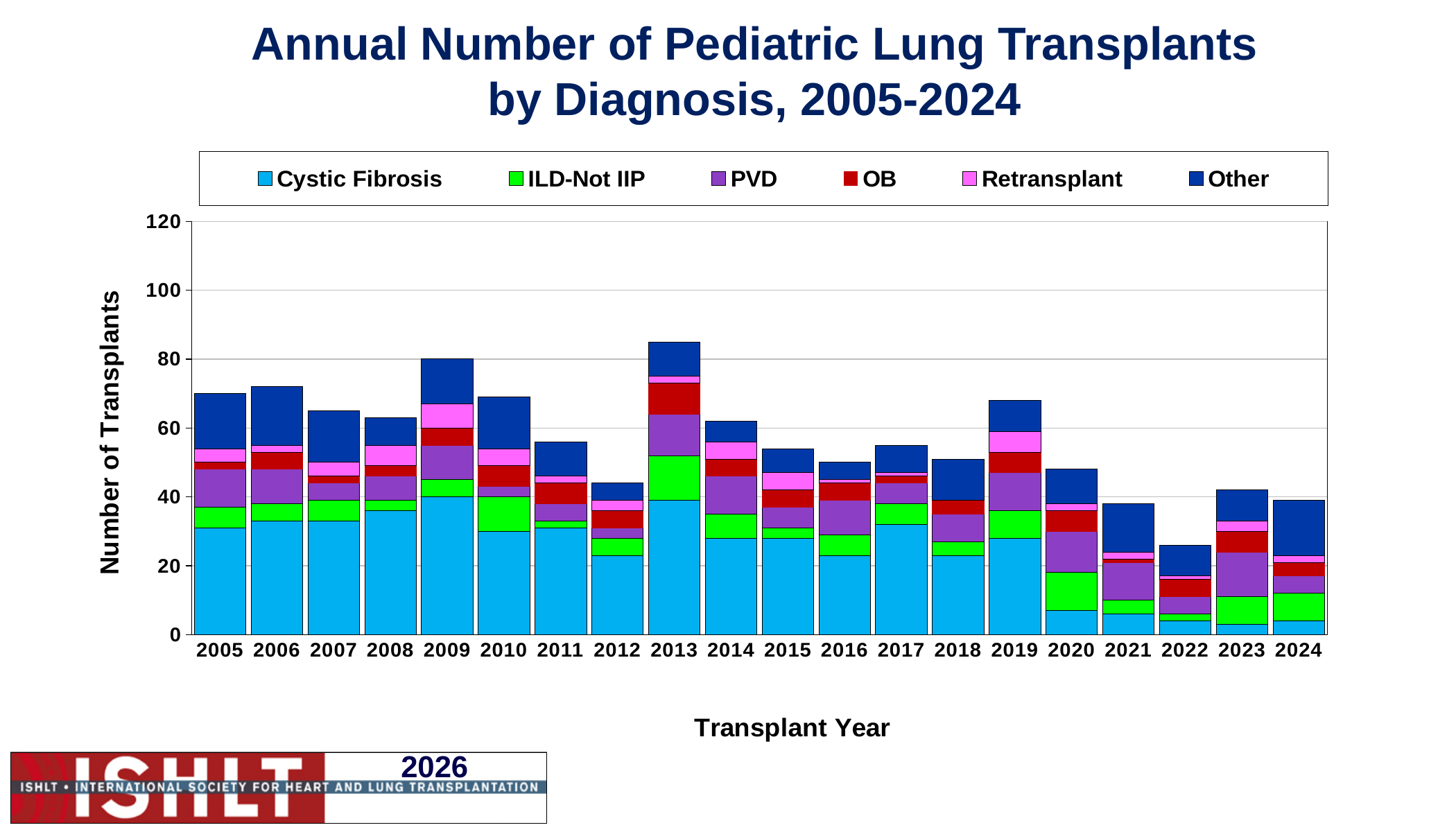
How many transplant years are shown along the x axis? 20 Which year has a larger total number of transplants, 2012 or 2013? 2013 What kind of chart is shown on the slide? Stacked bar chart Is the total number of transplants in 2022 greater or less than 40? less Is the total number of transplants in 2013 greater or less than 80? greater How many diagnosis series does the legend list? 6 What is the label of the x axis? Transplant Year Which year has the lowest total number of pediatric lung transplants? 2022 Which year has a larger total number of transplants, 2019 or 2020? 2019 From 2019 to 2022, do the total annual transplant numbers rise or fall? fall Is the total number of transplants in 2020 greater or less than 60? less Which year has the highest total number of pediatric lung transplants? 2013